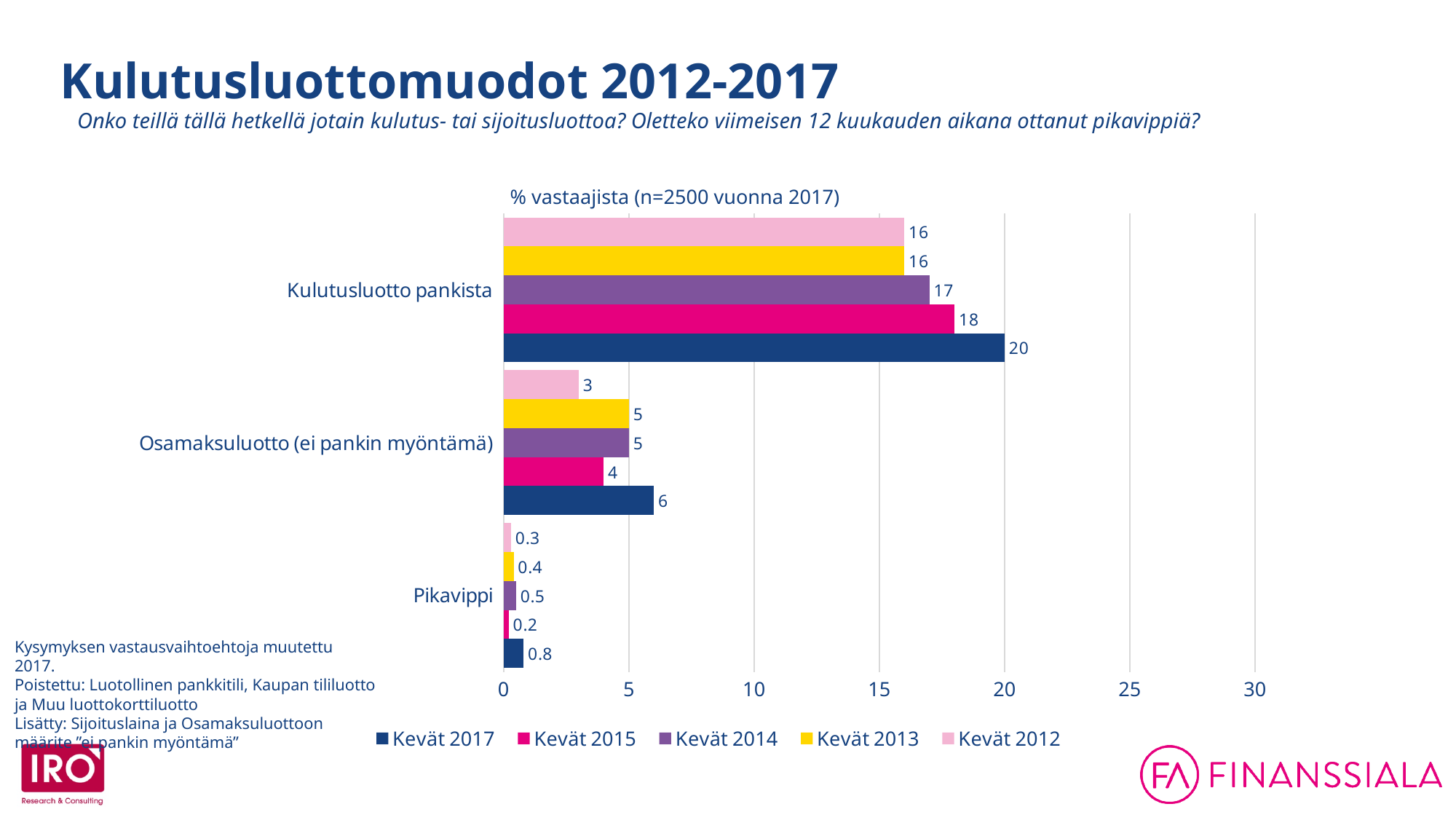
What is the total of the Kevät 2017 values across all three categories? 26.8 What kind of chart is shown on the slide? Bar chart What is the difference between the Kevät 2017 and Kevät 2012 values for Kulutusluotto pankista? 4 How many categories are shown on the chart? 3 For Osamaksuluotto (ei pankin myöntämä), which is larger: the Kevät 2017 value or the Kevät 2015 value? Kevät 2017 What is the value for Kulutusluotto pankista in the Kevät 2017 series? 20 How many series does the legend list? 5 Which category has the highest value in the Kevät 2017 series? Kulutusluotto pankista What is the value for Pikavippi in the Kevät 2015 series? 0.2 What is the value for Kulutusluotto pankista in the Kevät 2014 series? 17 What is the value for Osamaksuluotto (ei pankin myöntämä) in the Kevät 2012 series? 3 Which category has the lowest value in the Kevät 2013 series? Pikavippi